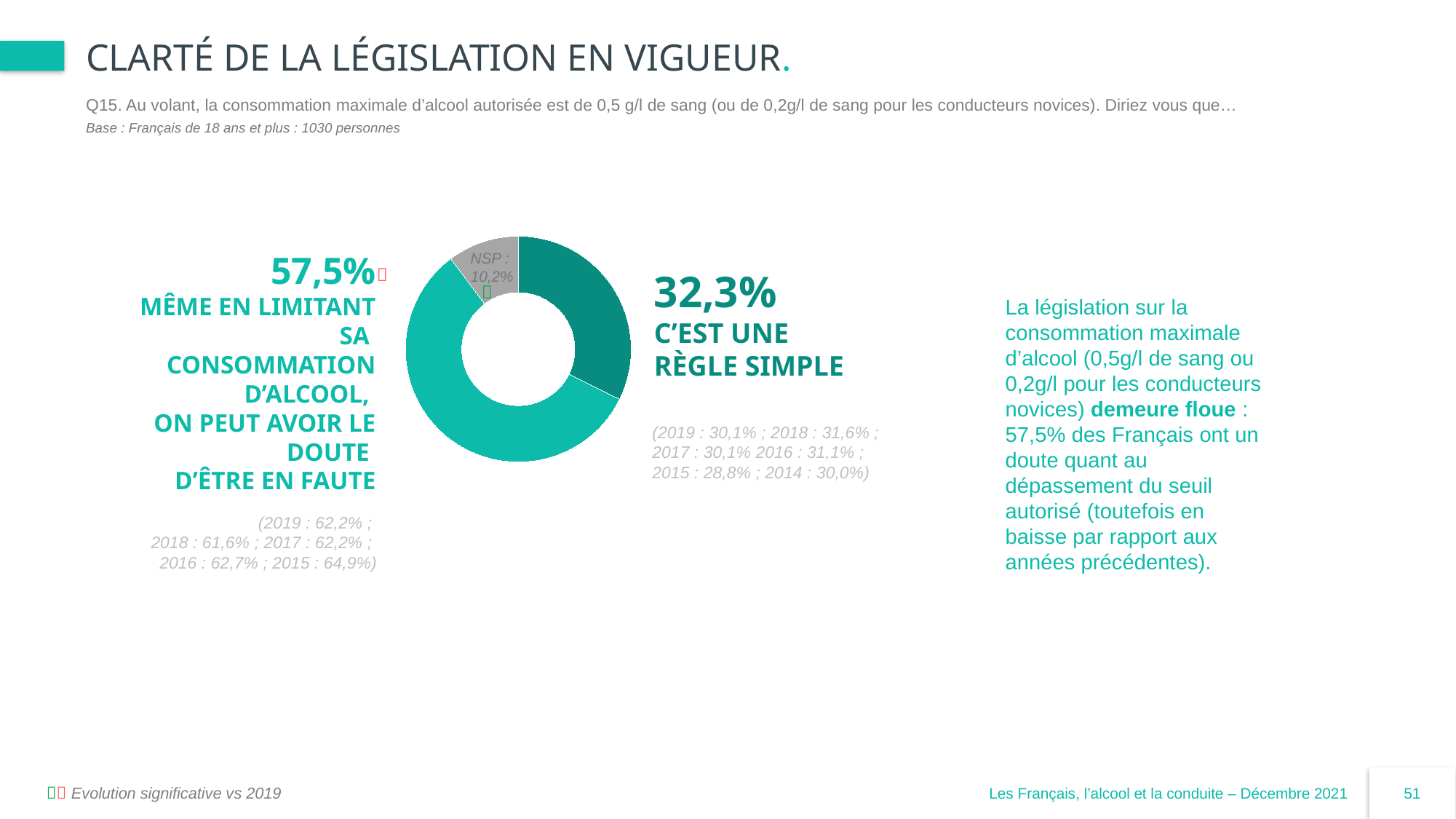
How many slices does the donut chart have? 3 What share of respondents say "C'est une règle simple"? 32,3% What is the value of the NSP slice? 10,2% Which slice of the donut chart is the largest? Même en limitant sa consommation d'alcool, on peut avoir le doute d'être en faute (57,5%) What kind of chart is shown on the slide? Donut (pie) chart What share of respondents say that even when limiting their alcohol consumption, one can doubt being at fault? 57,5% Which is larger: the share saying "C'est une règle simple" or the NSP share? C'est une règle simple What was the share for "C'est une règle simple" in 2019, according to the slide? 30,1% Which slice of the donut chart is the smallest? NSP (10,2%) What was the share for the "doute d'être en faute" answer in 2015, according to the slide? 64,9% What is the difference between the 57,5% slice and the 32,3% slice? 25,2 points What colour is the NSP slice of the donut chart? Grey